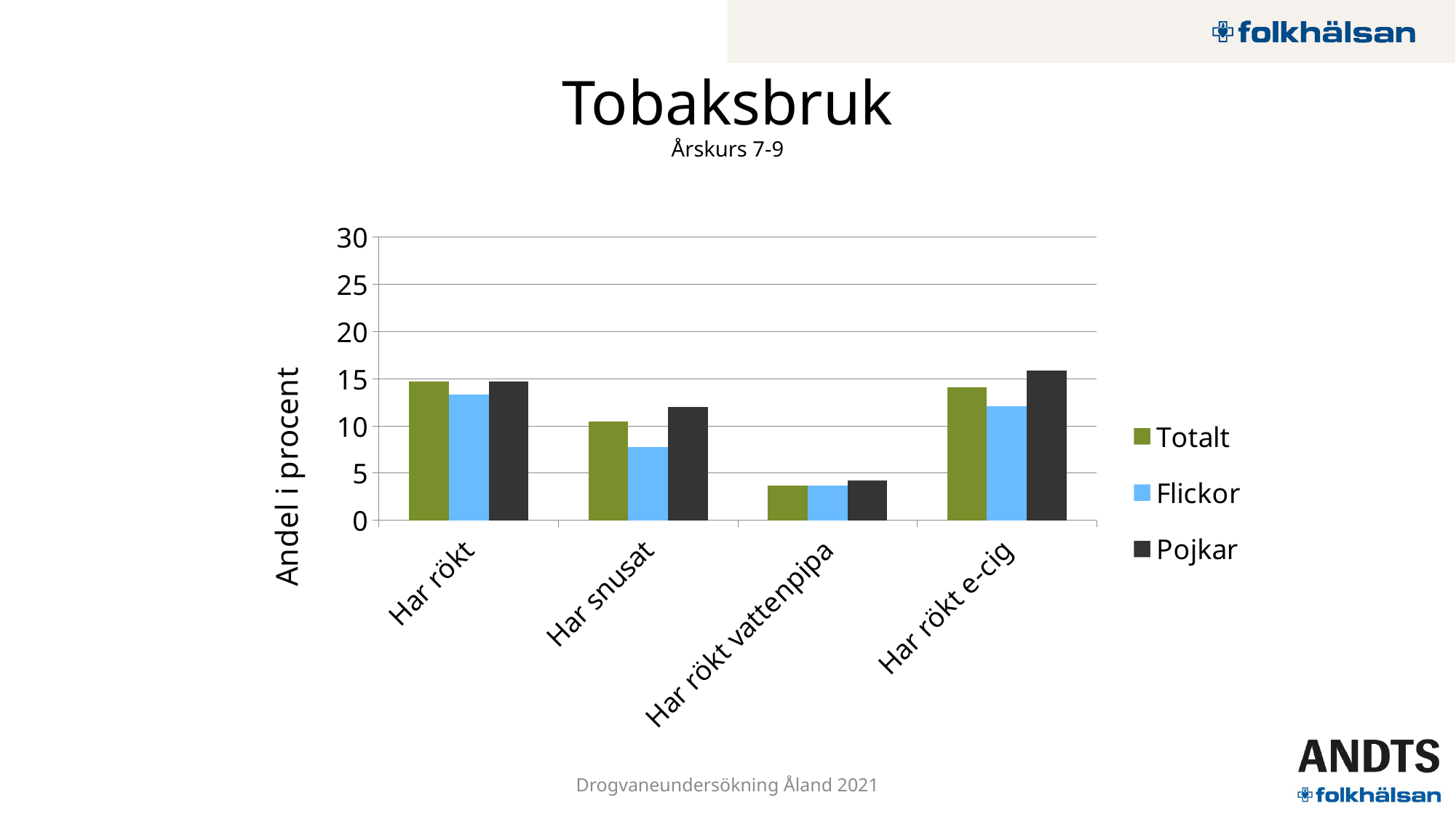
What is the title of the chart's vertical axis? Andel i procent Is the value for Pojkar in the category Har snusat greater or less than 10? greater Which category has the highest value for the Pojkar series? Har rökt e-cig How many categories are shown on the x axis of the chart? 4 Which category has the lowest value for the Totalt series? Har rökt vattenpipa Within the category Har snusat, which series has the highest value? Pojkar Is the value for Flickor in the category Har snusat greater or less than 10? less Which category has the lowest value for the Pojkar series? Har rökt vattenpipa Is the value for Totalt in the category Har rökt vattenpipa greater or less than 5? less What kind of chart is shown on the slide? bar chart How many series does the chart's legend list? 3 In the category Har rökt e-cig, which is larger: the value for Flickor or the value for Pojkar? Pojkar